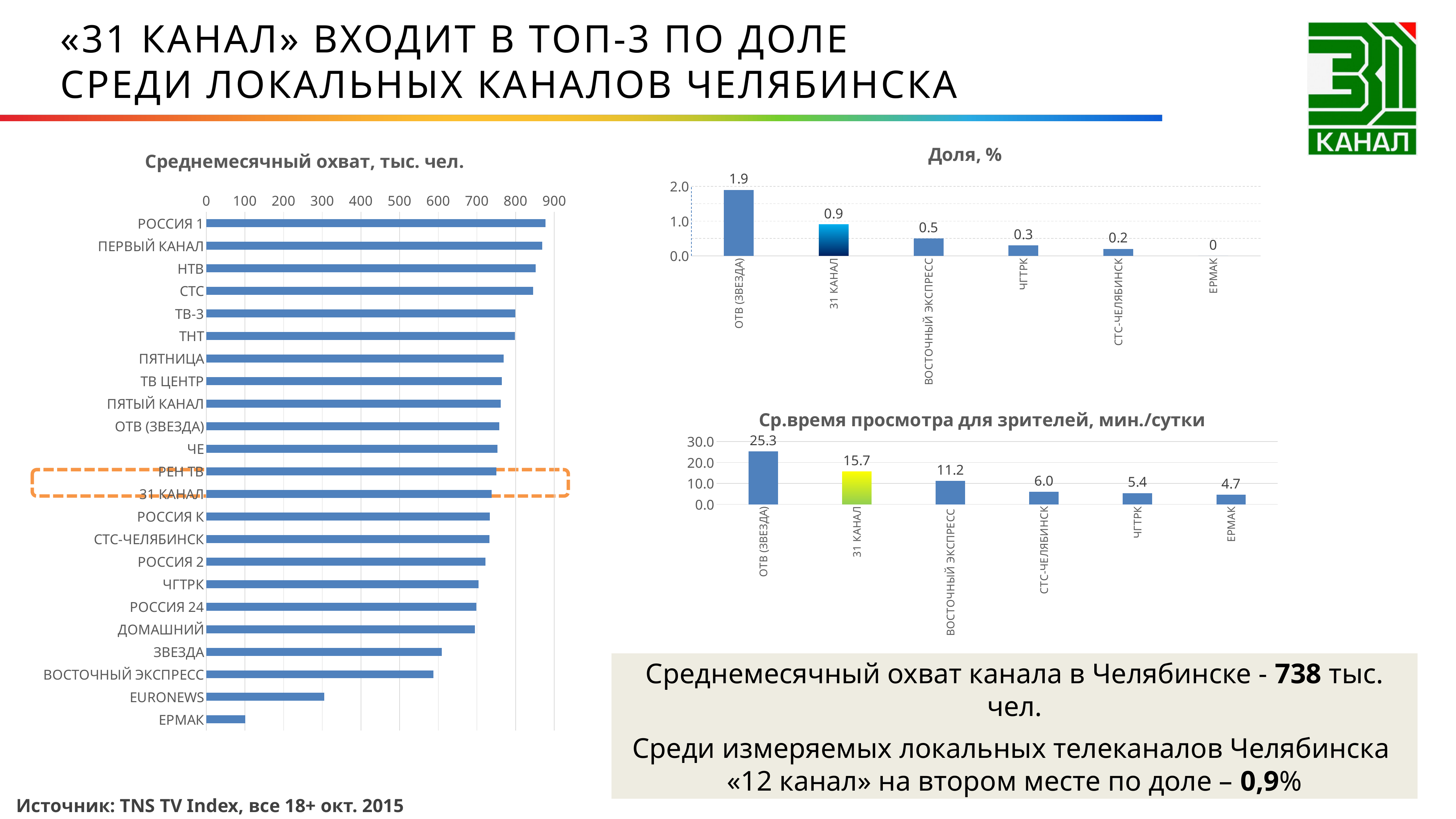
On the 'Среднемесячный охват, тыс. чел.' chart, is the value for ЕРМАК greater or less than 200? less On the 'Доля, %' chart, what is the value for ОТВ (ЗВЕЗДА)? 1.9 On the 'Ср.время просмотра для зрителей, мин./сутки' chart, how many channels are shown? 6 On the 'Среднемесячный охват, тыс. чел.' chart, is the value for РОССИЯ 1 greater or less than 800? greater On the 'Доля, %' chart, what is the value for 31 КАНАЛ? 0.9 On the 'Ср.время просмотра для зрителей, мин./сутки' chart, which is larger: СТС-ЧЕЛЯБИНСК or ЧГТРК? СТС-ЧЕЛЯБИНСК On the 'Ср.время просмотра для зрителей, мин./сутки' chart, what is the value for ВОСТОЧНЫЙ ЭКСПРЕСС? 11.2 On the 'Доля, %' chart, what is the difference between ОТВ (ЗВЕЗДА) and 31 КАНАЛ? 1.0 On the 'Доля, %' chart, which channel has the lowest share? ЕРМАК What kind of chart is the 'Среднемесячный охват, тыс. чел.' chart? Bar chart On the 'Среднемесячный охват, тыс. чел.' chart, how many channels are listed? 23 On the 'Ср.время просмотра для зрителей, мин./сутки' chart, which channel has the highest value? ОТВ (ЗВЕЗДА)